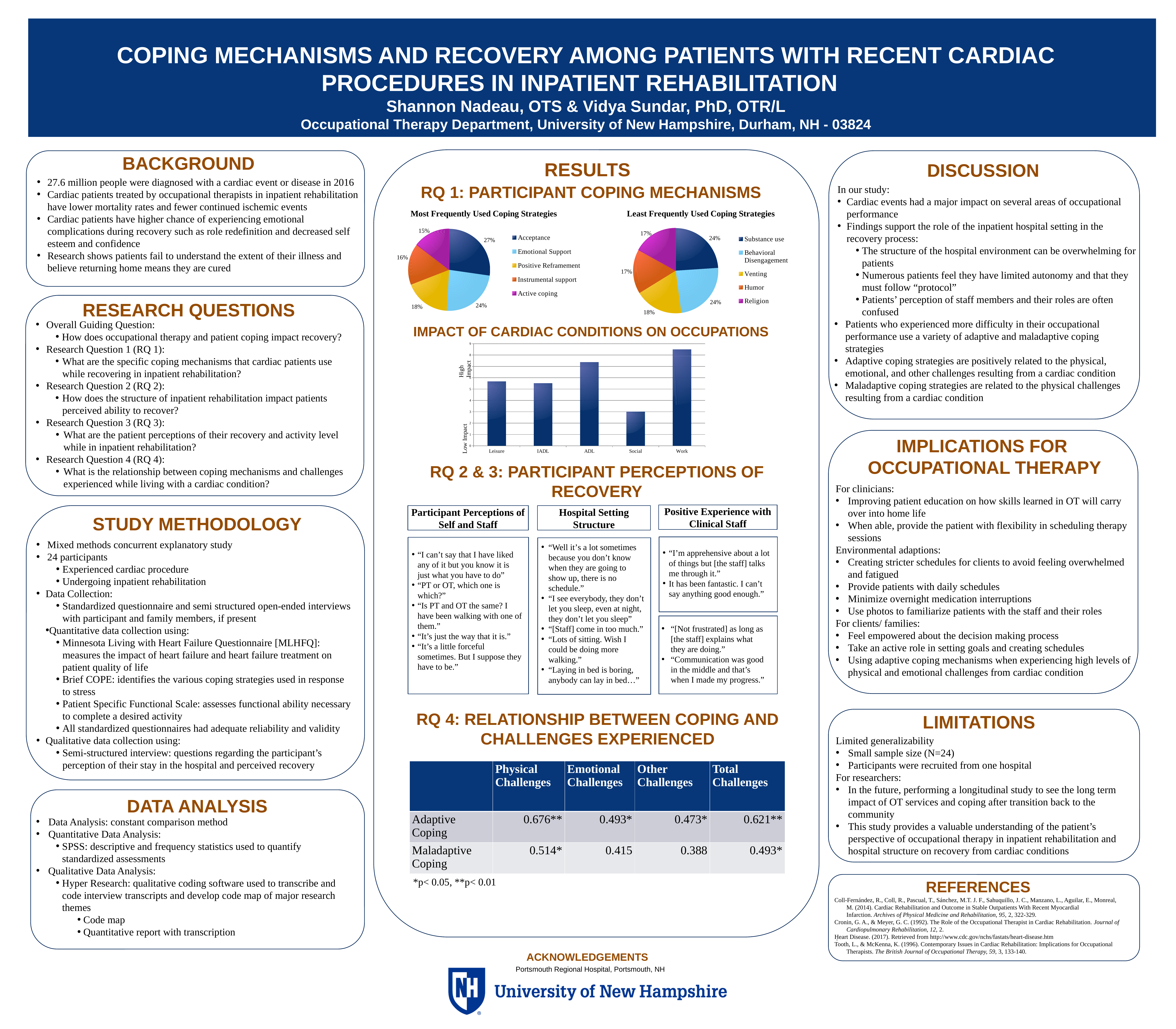
In the 'Most Frequently Used Coping Strategies' pie chart, what share is labelled for Acceptance? 27% In the 'Impact of Cardiac Conditions on Occupations' chart, which occupation has the highest bar? Work In the 'Impact of Cardiac Conditions on Occupations' chart, how many occupation categories are shown on the x axis? 5 In the 'Most Frequently Used Coping Strategies' pie chart, which coping strategy has the smallest share? Active coping In the 'Most Frequently Used Coping Strategies' pie chart, what is the difference in percentage points between Acceptance and Active coping? 12 In the 'Impact of Cardiac Conditions on Occupations' chart, is the value for ADL greater or less than 6? greater In the 'Least Frequently Used Coping Strategies' pie chart, what share is labelled for Venting? 18% In the 'Impact of Cardiac Conditions on Occupations' chart, which occupation has the lowest bar? Social In the 'Least Frequently Used Coping Strategies' pie chart, what share is labelled for Substance use? 24% In the 'Most Frequently Used Coping Strategies' pie chart, how many coping strategies does the legend list? 5 In the 'Most Frequently Used Coping Strategies' pie chart, what share is labelled for Emotional Support? 24% What type of chart is used for 'Least Frequently Used Coping Strategies'? Pie chart